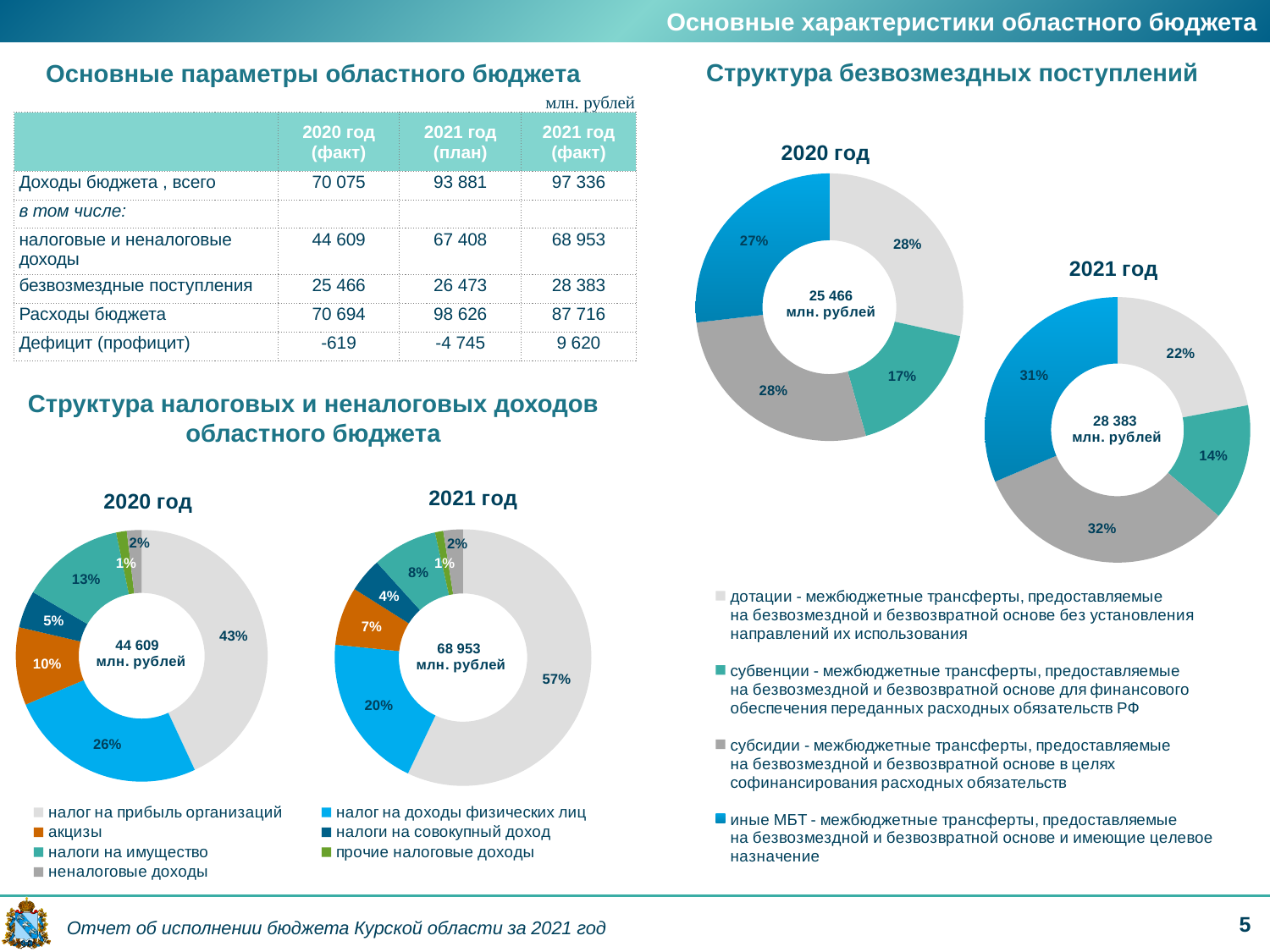
In the 2021 год chart under 'Структура налоговых и неналоговых доходов областного бюджета', which category has the largest share? налог на прибыль организаций In the 2020 год chart under 'Структура налоговых и неналоговых доходов областного бюджета', what share is налог на прибыль организаций? 43% In the 2021 год chart under 'Структура безвозмездных поступлений', what is the difference in percentage points between иные МБТ and дотации? 9 In the 2021 год chart under 'Структура безвозмездных поступлений', which category has the smallest share? субвенции In the 2020 год chart under 'Структура налоговых и неналоговых доходов областного бюджета', what is the difference in percentage points between налог на прибыль организаций and налог на доходы физических лиц? 17 How many categories does the legend list for the charts under 'Структура налоговых и неналоговых доходов областного бюджета'? 7 What total value is shown in the centre of the 2021 год chart under 'Структура налоговых и неналоговых доходов областного бюджета'? 68 953 млн. рублей In the 2020 год chart under 'Структура налоговых и неналоговых доходов областного бюджета', which category has the smallest share? прочие налоговые доходы What kind of chart is used for the 2020 год chart under 'Структура безвозмездных поступлений'? doughnut (pie) chart In the 2020 год chart under 'Структура безвозмездных поступлений', what share is субсидии? 28% In the 2021 год chart under 'Структура налоговых и неналоговых доходов областного бюджета', what share is налог на доходы физических лиц? 20% In the 2020 год chart under 'Структура налоговых и неналоговых доходов областного бюджета', which is larger: акцизы or налоги на имущество? налоги на имущество